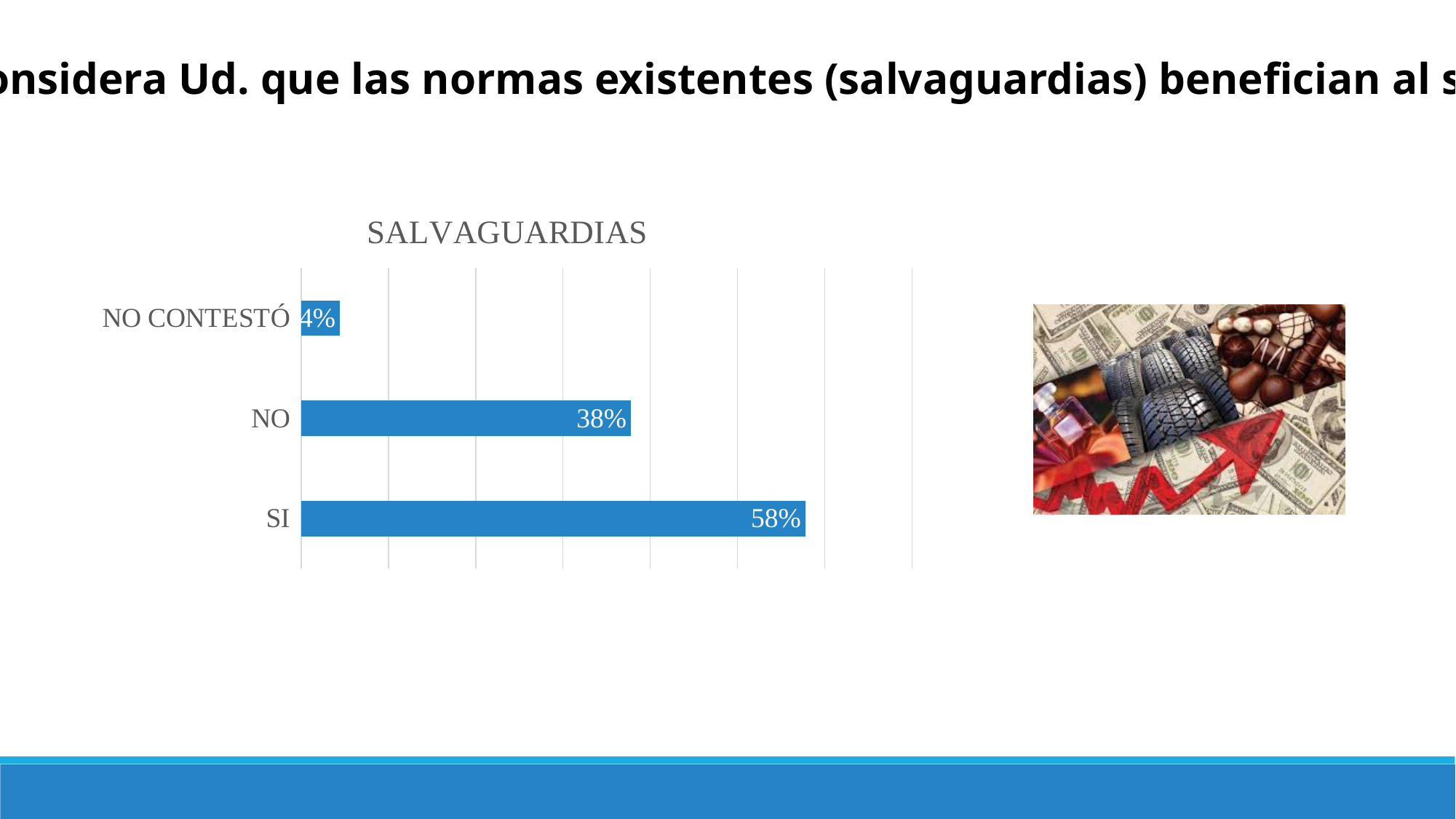
Which category has the lowest value in the SALVAGUARDIAS chart? NO CONTESTÓ What is the difference between the values for NO and NO CONTESTÓ in the SALVAGUARDIAS chart? 34% What kind of chart is the SALVAGUARDIAS chart? Bar chart What is the title of the chart on the slide? SALVAGUARDIAS What is the value for NO CONTESTÓ in the SALVAGUARDIAS chart? 4% What colour are the bars in the SALVAGUARDIAS chart? Blue Which is larger in the SALVAGUARDIAS chart, the value for NO or the value for NO CONTESTÓ? NO What is the difference between the values for SI and NO in the SALVAGUARDIAS chart? 20% What is the value for SI in the SALVAGUARDIAS chart? 58% Which category has the highest value in the SALVAGUARDIAS chart? SI What is the value for NO in the SALVAGUARDIAS chart? 38% How many categories are shown in the SALVAGUARDIAS chart? 3